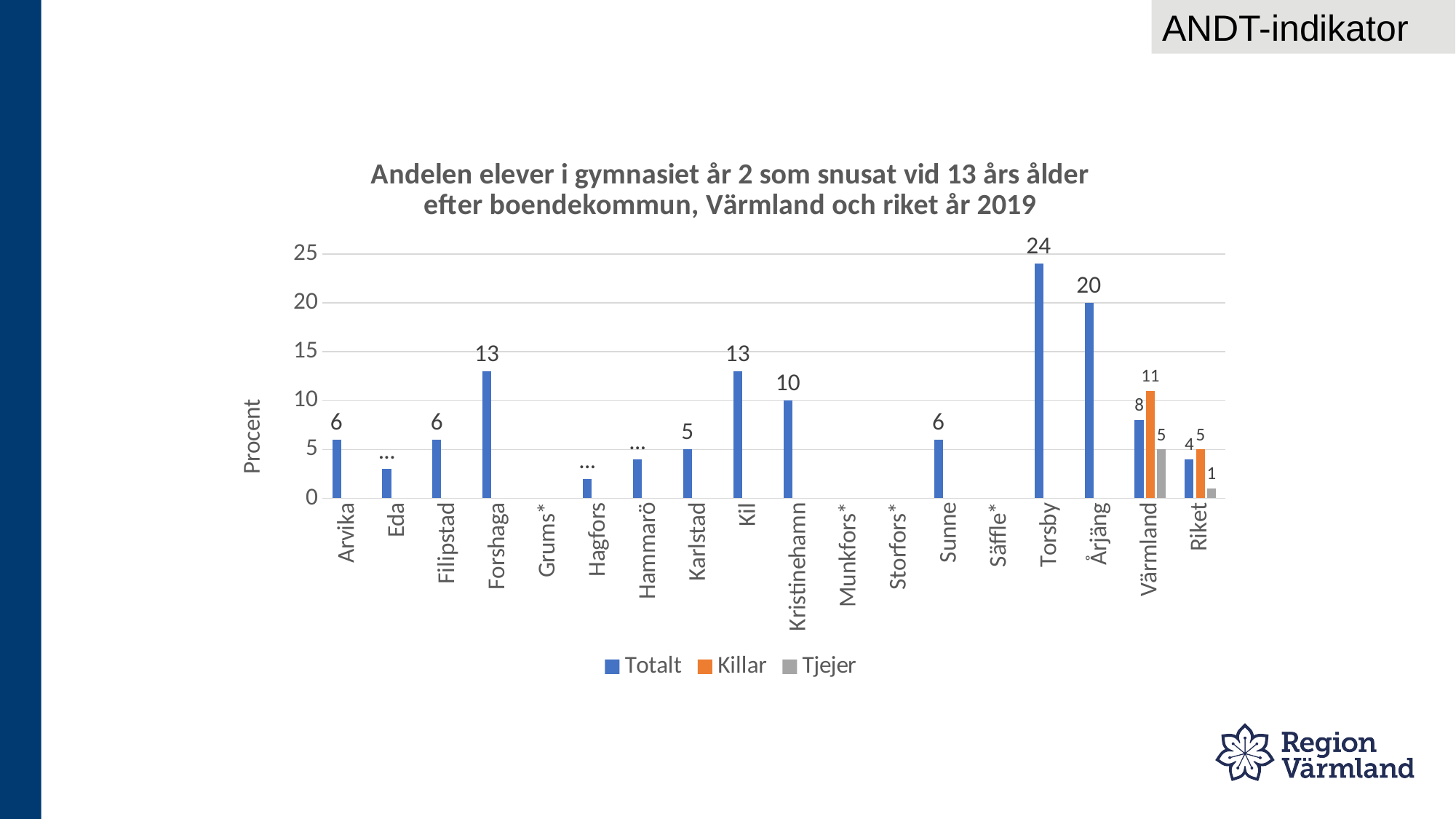
What kind of chart is shown on the slide? Bar chart What is the Totalt value for Torsby? 24 What is the Killar value for Värmland? 11 What is the label of the vertical axis? Procent What is the difference between the Totalt values for Torsby and Årjäng? 4 How many series does the legend list? 3 What is the difference between the Killar and Tjejer values for Värmland? 6 What is the Tjejer value for Riket? 1 Which has a higher Totalt value, Forshaga or Kristinehamn? Forshaga Which category has the highest Totalt value? Torsby Is the Totalt value for Eda greater or less than 5? less How many categories are shown on the x axis? 18